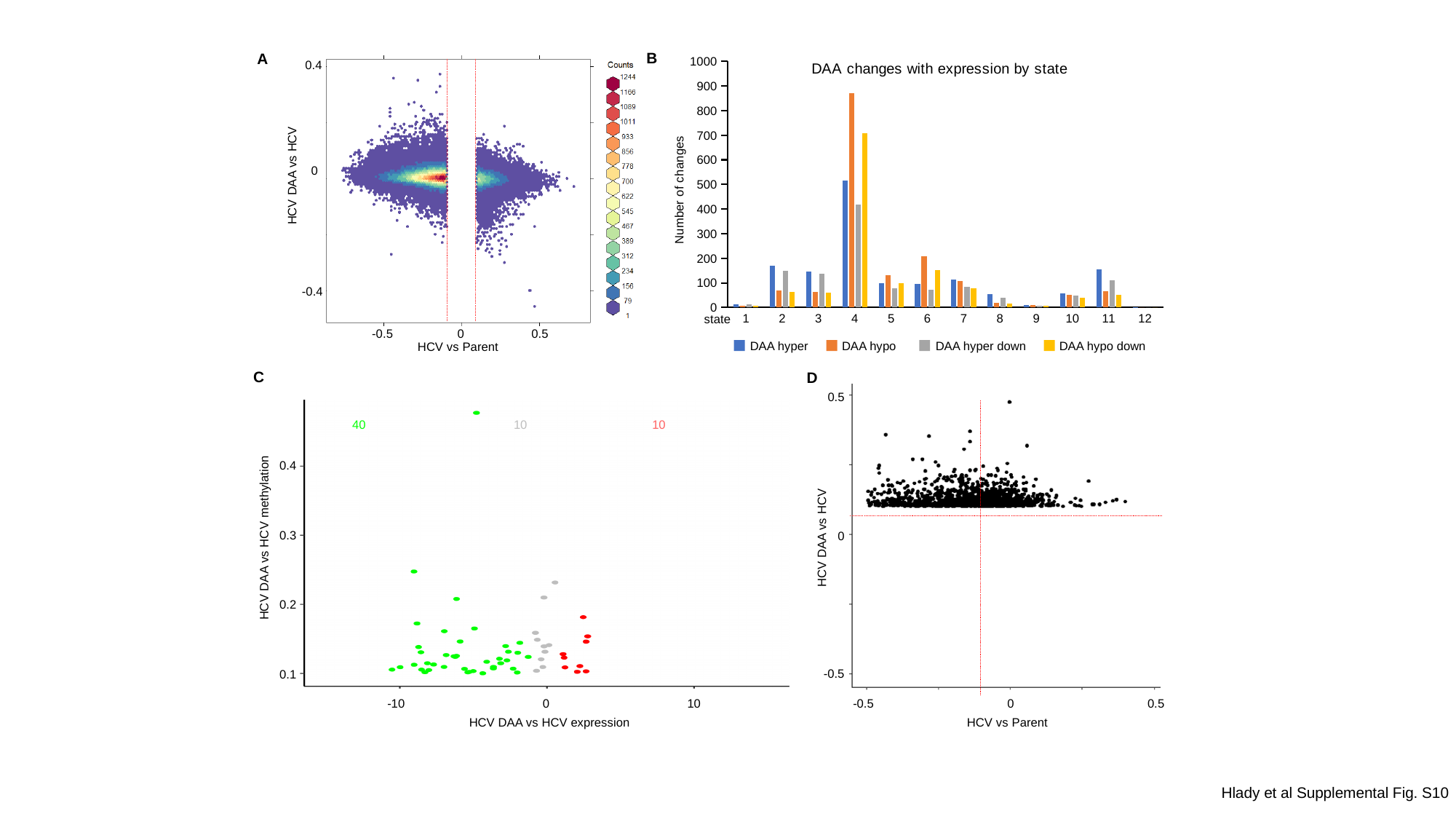
In the chart 'DAA changes with expression by state', is the DAA hypo down value for state 4 greater or less than 600? greater In the chart 'DAA changes with expression by state', which state has the highest DAA hyper value? 4 In the chart 'DAA changes with expression by state', how many states are shown on the x axis? 12 In the chart 'DAA changes with expression by state', which is larger for state 4: DAA hyper or DAA hypo? DAA hypo In the chart 'DAA changes with expression by state', which is larger for state 2: DAA hyper or DAA hypo? DAA hyper What kind of chart is panel B, 'DAA changes with expression by state'? bar chart In the chart 'DAA changes with expression by state', which state has the highest DAA hypo value? 4 In the chart 'DAA changes with expression by state', is the DAA hyper value for state 12 greater or less than 100? less In the chart 'DAA changes with expression by state', how many series does the legend list? 4 What is the y-axis label of the chart 'DAA changes with expression by state'? Number of changes In the chart 'DAA changes with expression by state', is the DAA hyper value for state 2 greater or less than 100? greater